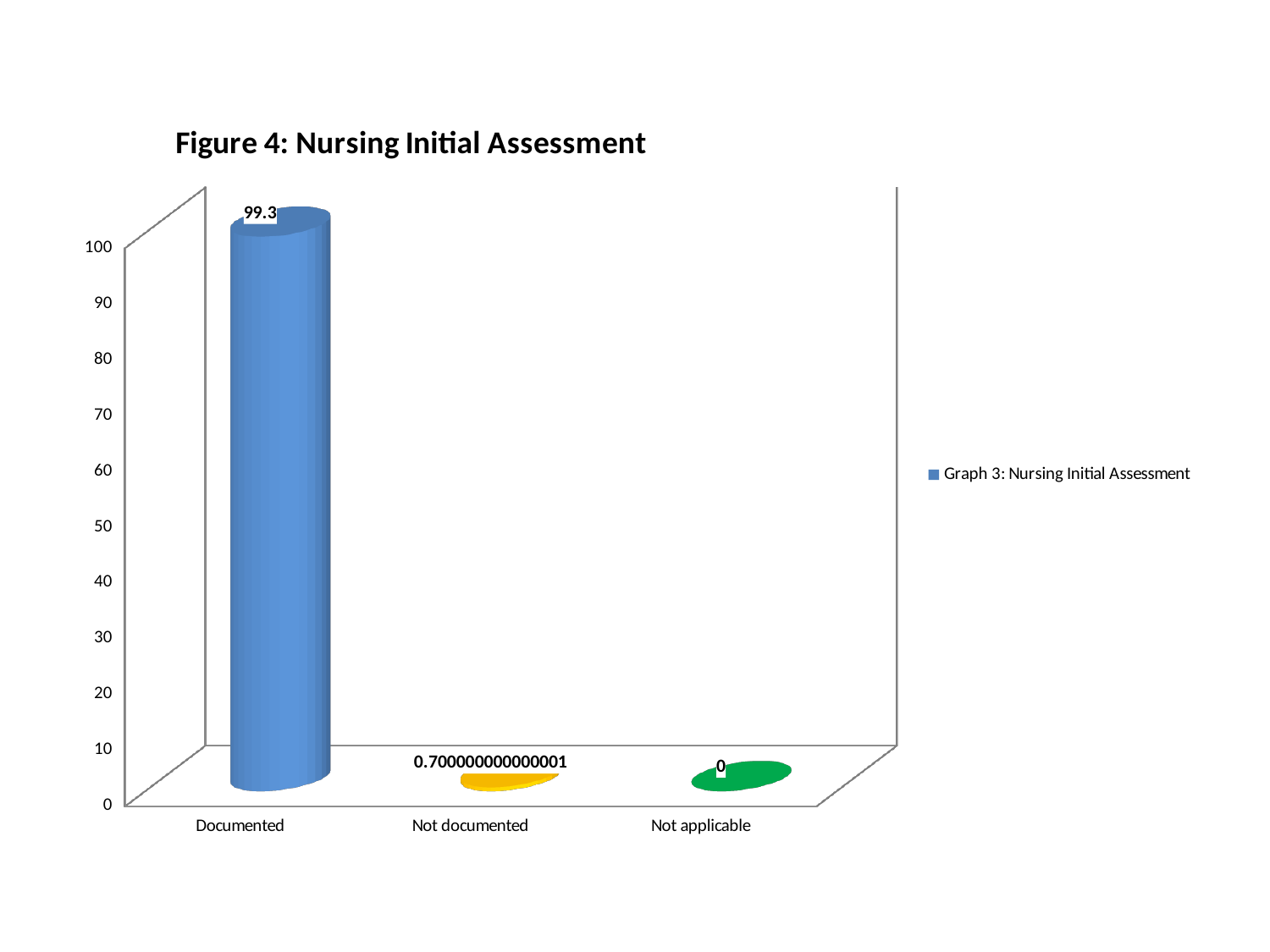
Which category has the lowest value? Not applicable Is the value for Documented greater or less than 90? greater Which category has the highest value? Documented What is the value for Not documented? 0.700000000000001 What is the value for Documented? 99.3 Which is larger, the value for Documented or the value for Not documented? Documented How many categories are shown on the x axis? 3 What is the value for Not applicable? 0 What kind of chart is shown? bar chart What is the legend entry for the series? Graph 3: Nursing Initial Assessment How many series does the legend list? 1 What is the title of the chart? Figure 4: Nursing Initial Assessment